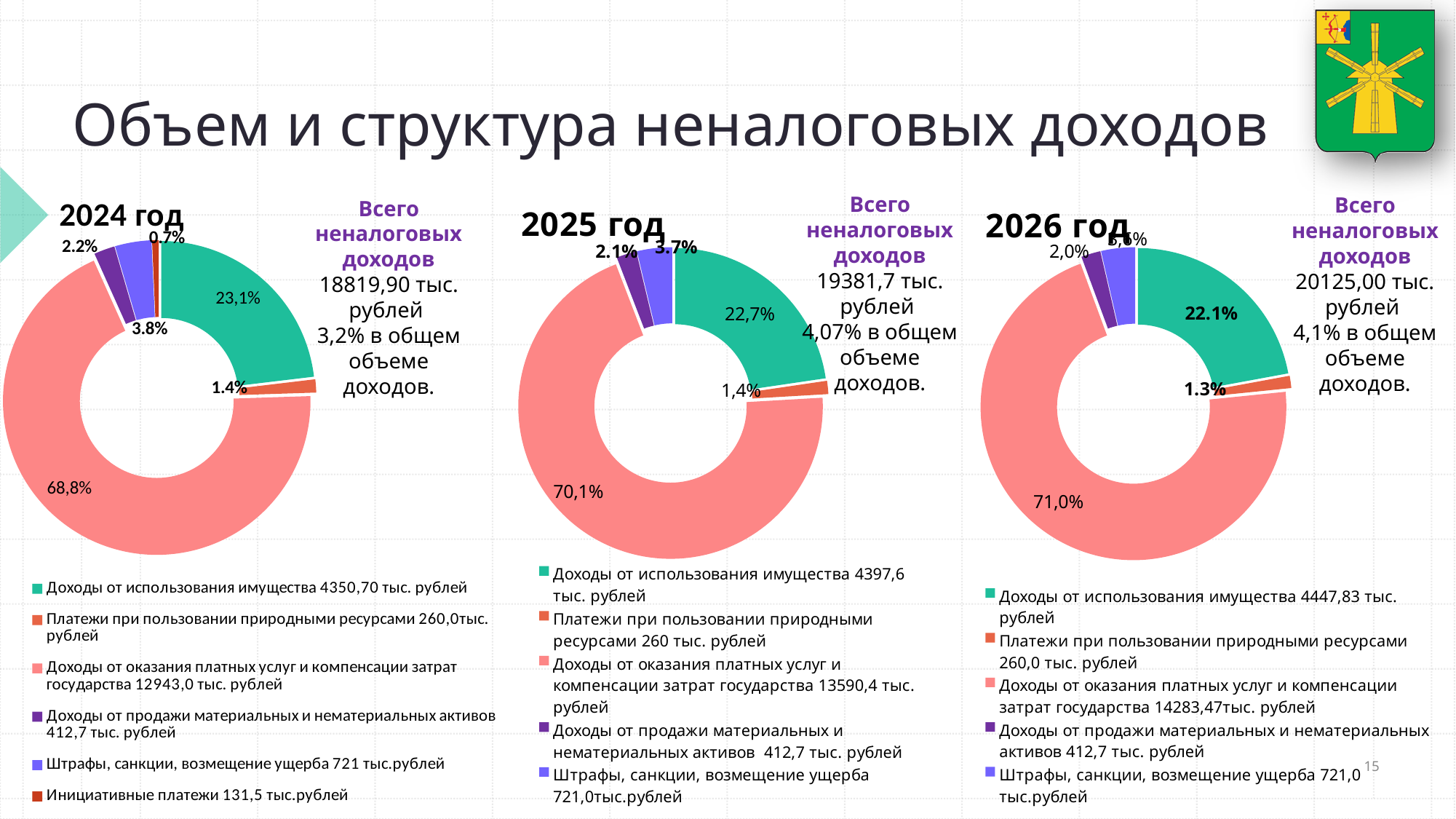
What kind of chart is used for the 2024 год data? Pie (donut) chart In the 2026 год chart, which is larger: the share for Доходы от использования имущества or the share for Штрафы, санкции, возмещение ущерба? Доходы от использования имущества In the 2026 год chart, which category has the largest share? Доходы от оказания платных услуг и компенсации затрат государства In the 2025 год chart, what is the difference between the share for Доходы от оказания платных услуг и компенсации затрат государства and the share for Доходы от использования имущества? 47,4% How many categories does the legend of the 2024 год chart list? 6 According to the text next to the 2025 год chart, what is the total of non-tax revenues (Всего неналоговых доходов)? 19381,7 тыс. рублей In the 2024 год chart, what share is shown for Доходы от оказания платных услуг и компенсации затрат государства? 68,8% In the 2024 год chart, which category has the smallest share? Инициативные платежи In the 2024 год chart, what share is shown for Доходы от использования имущества? 23,1% How many categories does the legend of the 2025 год chart list? 5 In the 2026 год chart, what share is shown for Доходы от оказания платных услуг и компенсации затрат государства? 71,0% In the 2025 год chart, what share is shown for Штрафы, санкции, возмещение ущерба? 3.7%